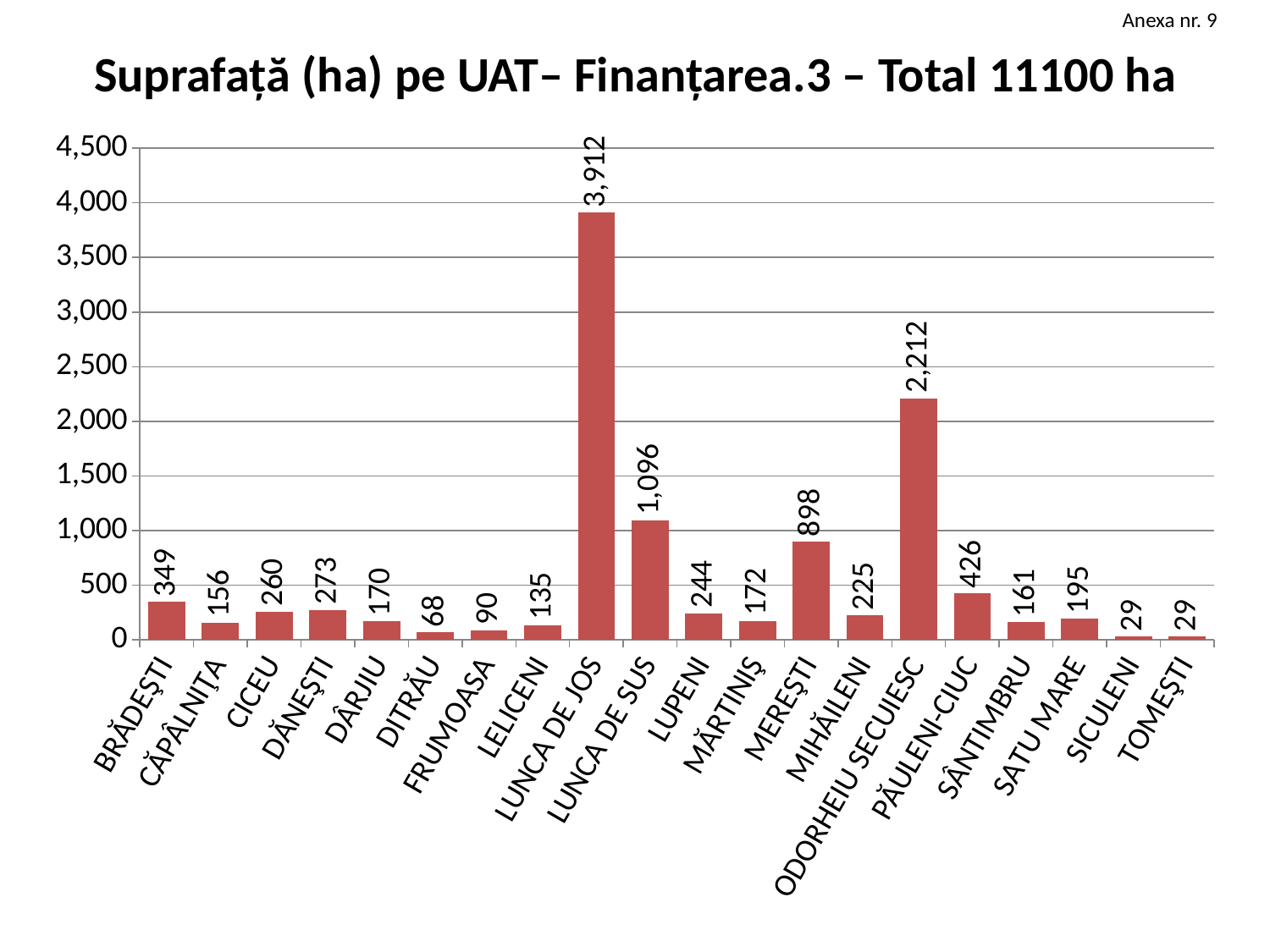
Which is larger, the value for LUNCA DE SUS or the value for MEREȘTI? LUNCA DE SUS What is the difference between the values for LUNCA DE JOS and ODORHEIU SECUIESC? 1,700 Which UAT has the highest value? LUNCA DE JOS What is the value for PĂULENI-CIUC? 426 What is the value for LUNCA DE JOS? 3,912 What is the difference between the values for MEREȘTI and PĂULENI-CIUC? 472 How many UATs are shown on the x axis? 20 What is the value for ODORHEIU SECUIESC? 2,212 What is the value for DITRĂU? 68 Is the value for LUNCA DE JOS greater or less than 3,500? greater What kind of chart is shown on the slide? bar chart What total in hectares is stated in the chart title? 11100 ha